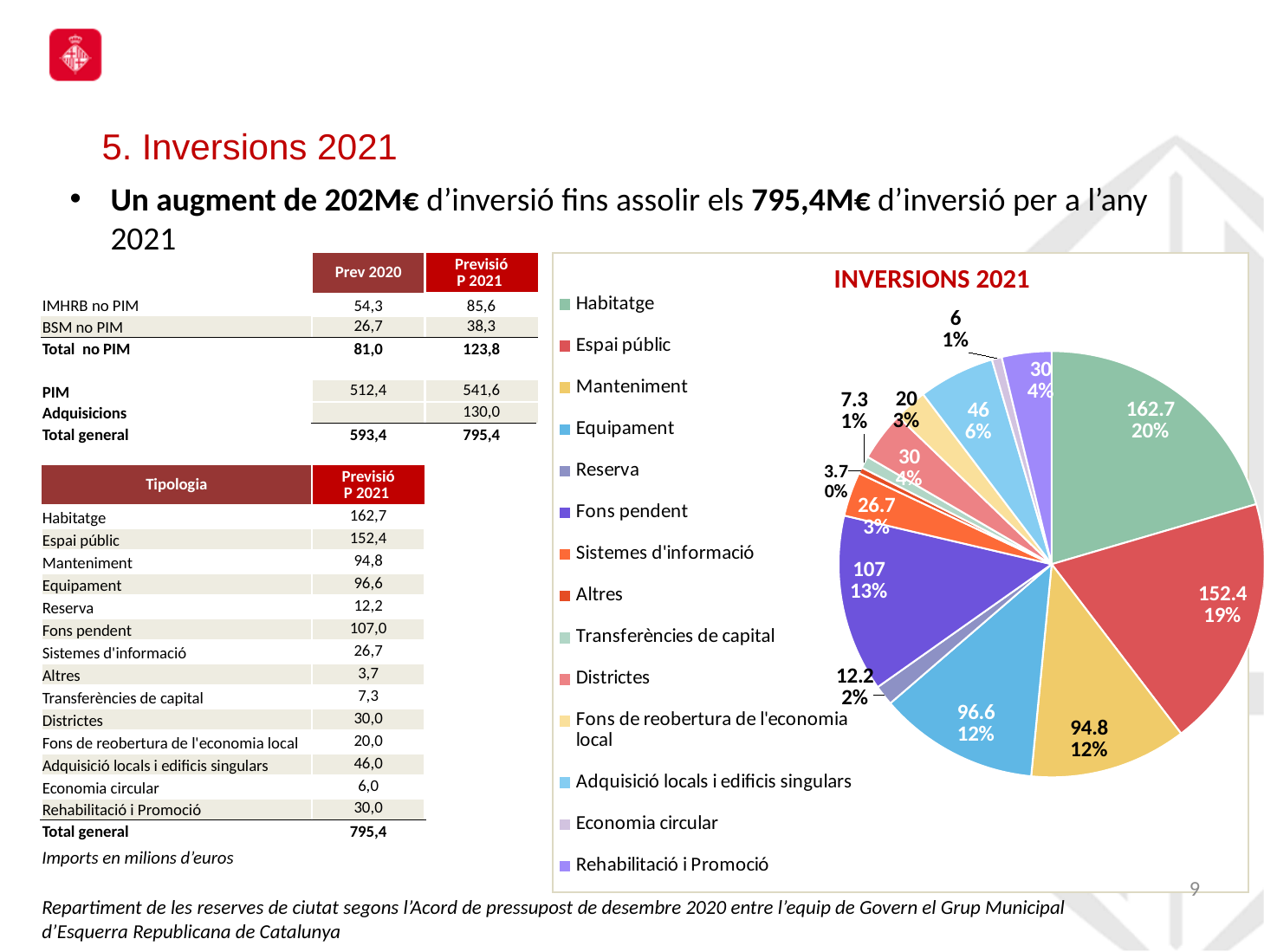
How many categories does the legend of the pie chart list? 14 Which category has the largest slice in the pie chart? Habitatge What type of chart is shown on the slide? pie chart What is the title of the chart? INVERSIONS 2021 Which is larger in the pie chart, Equipament or Reserva? Equipament What value is shown for Adquisició locals i edificis singulars in the pie chart? 46 What share of the pie does Fons pendent represent? 13% Which category has the smallest slice in the pie chart? Altres What value is shown for Fons pendent in the pie chart? 107 What share of the pie does Espai públic represent? 19% What value is shown for Habitatge in the pie chart? 162.7 What is the difference between the values for Habitatge and Espai públic in the pie chart? 10.3